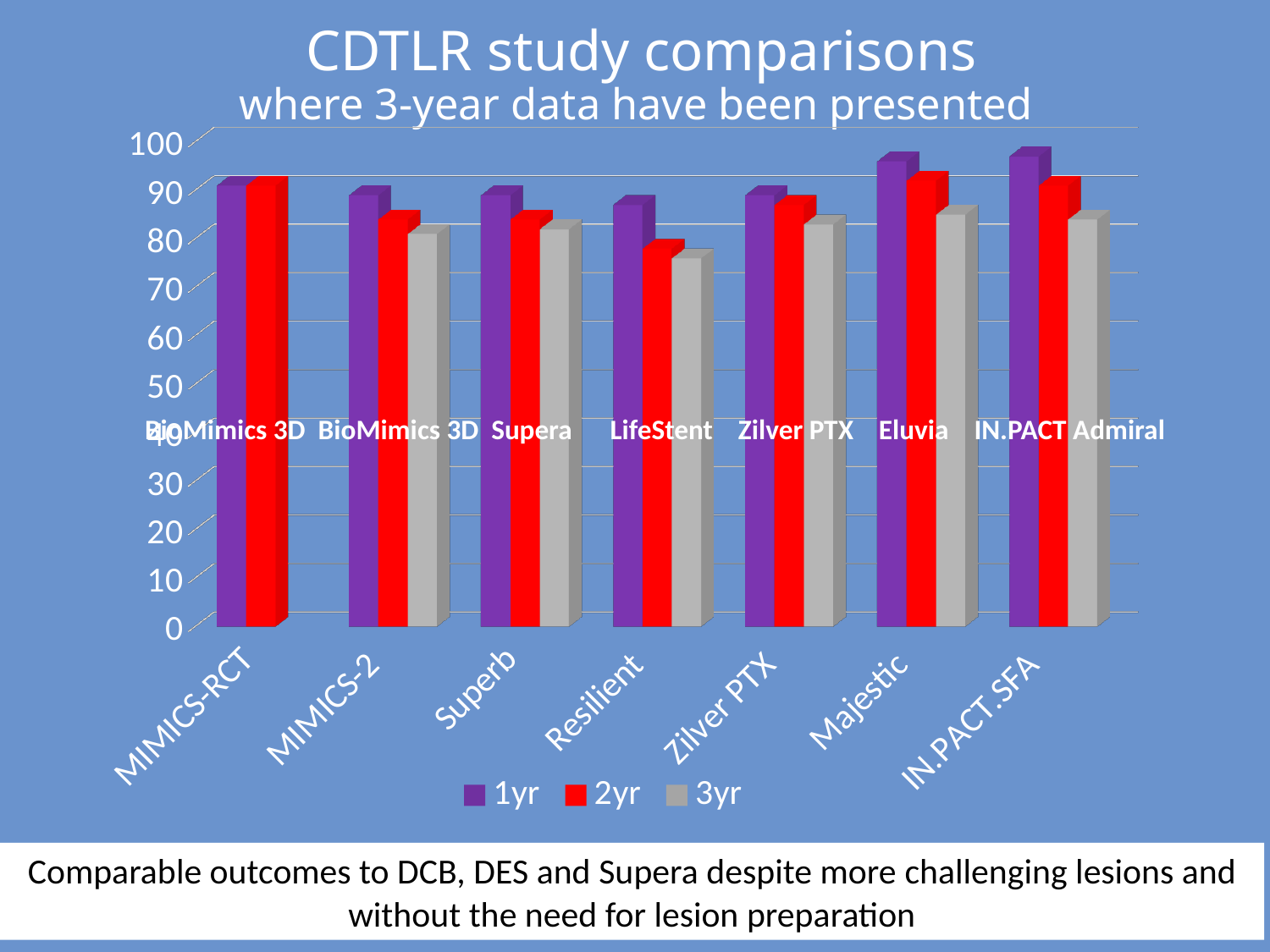
How many study categories are shown along the x axis? 7 Which is larger, the 3yr value for Zilver PTX or the 3yr value for Resilient? Zilver PTX Which study has the lowest 2yr value? Resilient Is the 1yr value for Majestic greater or less than 90? greater Within the Superb study, do the values rise or fall from 1yr to 3yr? fall What are the series names listed in the legend? 1yr, 2yr, 3yr Is the 3yr value for Resilient greater or less than 80? less Which study is missing a 3yr bar? MIMICS-RCT Is the 1yr value for Resilient greater or less than 90? less How many series does the legend list? 3 Which study has the lowest 3yr value? Resilient What kind of chart is shown on the slide? bar chart